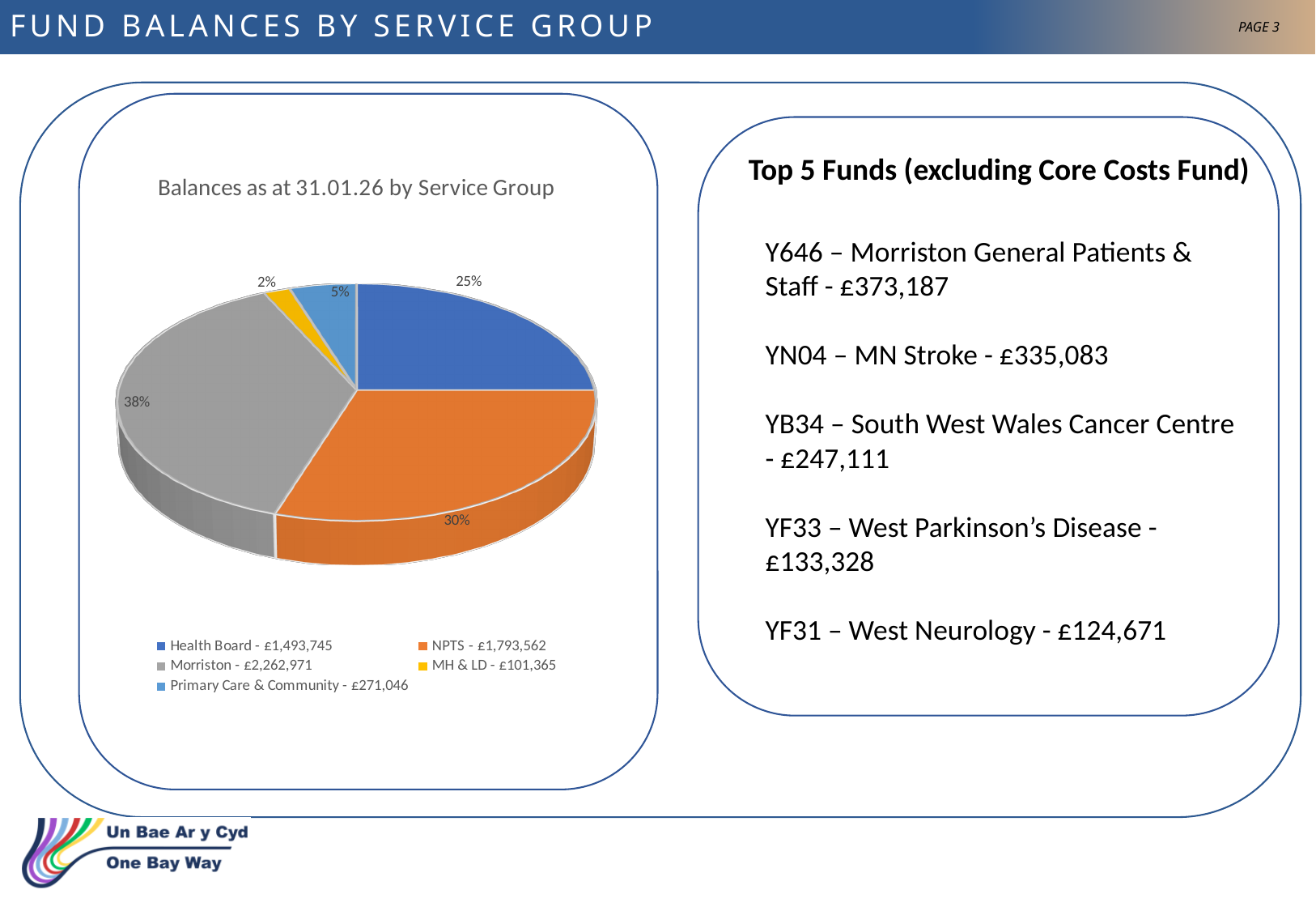
How many service groups (slices) does the pie chart show? 5 What share of the pie does Morriston represent? 38% What share of the pie does Primary Care & Community represent? 5% What is the difference between the Morriston balance and the NPTS balance? £469,409 What is the balance for Health Board according to the legend? £1,493,745 Which service group has the largest balance? Morriston What share of the pie does NPTS represent? 30% What is the title of the chart? Balances as at 31.01.26 by Service Group Which has the larger balance, NPTS or Health Board? NPTS What is the balance for MH & LD according to the legend? £101,365 What kind of chart is shown on the slide? Pie chart Which service group has the smallest balance? MH & LD